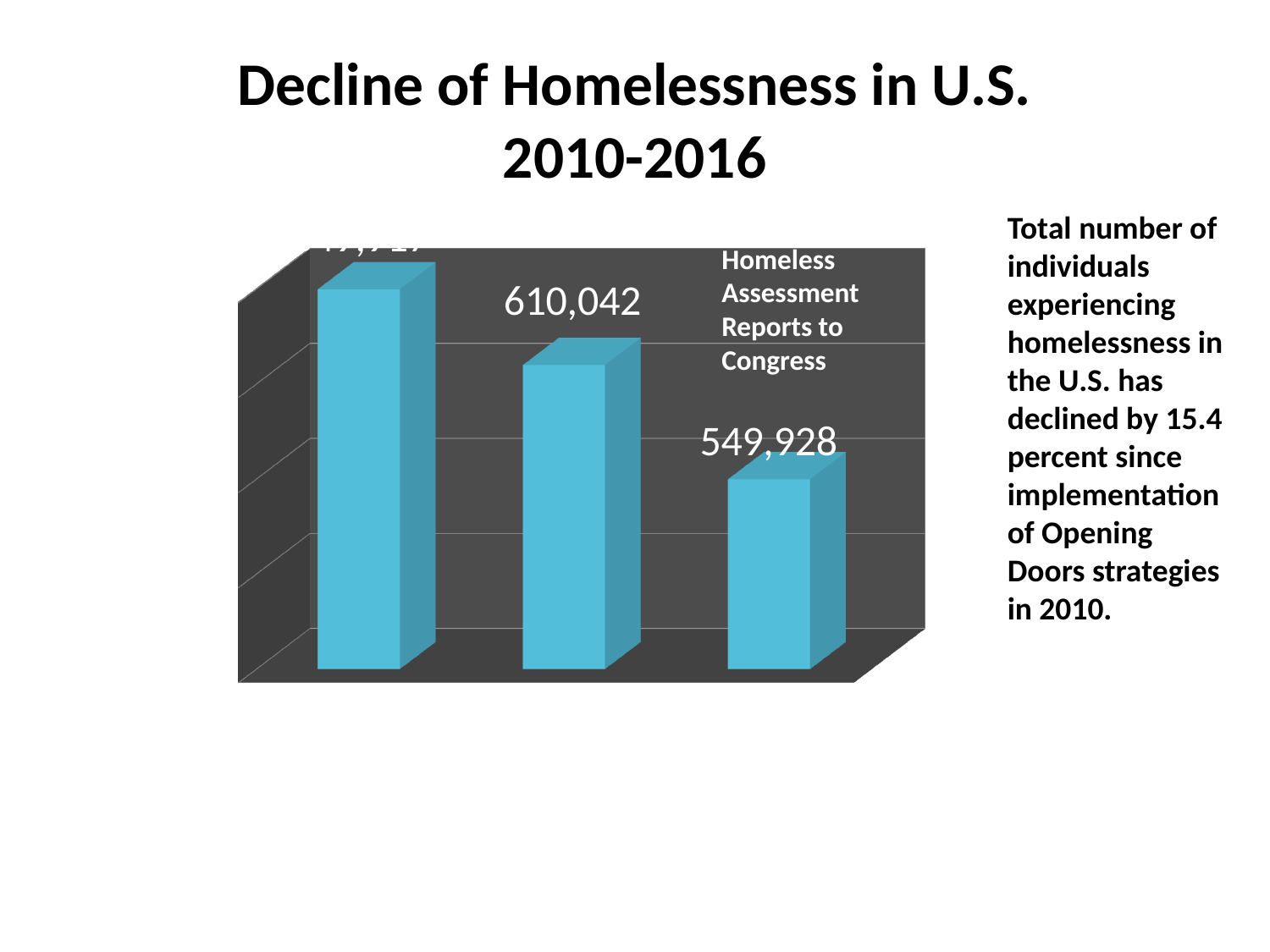
What kind of chart is shown on the slide? bar chart Which bar in the chart is the shortest? the rightmost bar What text label appears inside the chart area in the upper right? Homeless Assessment Reports to Congress Which bar in the chart is the tallest? the leftmost bar How many bars are plotted in the chart? 3 What is the value shown on the rightmost bar of the chart? 549,928 What colour are the bars in the chart? blue Do the bar values rise or fall from left to right across the chart? fall What is the difference between the middle bar's value and the rightmost bar's value? 60,114 Which is larger, the middle bar or the rightmost bar? the middle bar What is the value shown on the middle bar of the chart? 610,042